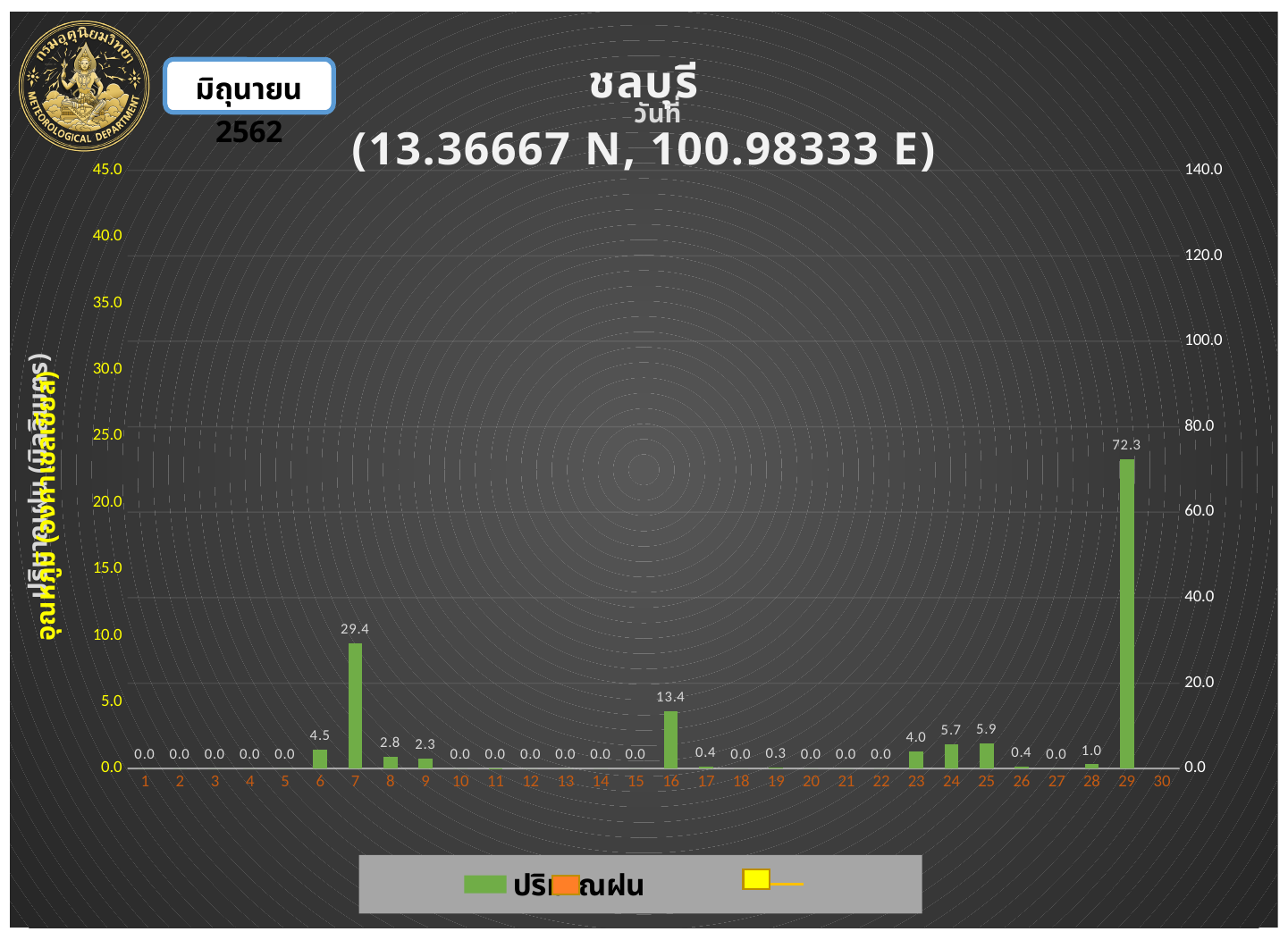
What is the rainfall value shown for day 29? 72.3 Is the value for day 29 greater or less than 60.0 on the right-hand axis? greater What is the rainfall value shown for day 24? 5.7 Which has a larger rainfall value, day 7 or day 16? day 7 What is the rainfall value shown for day 16? 13.4 What coordinates are given in the chart title? 13.36667 N, 100.98333 E Which day has the highest rainfall value? 29 What is the difference between the rainfall values for day 25 and day 24? 0.2 How many days are shown along the x axis? 30 What is the difference between the rainfall values for day 7 and day 16? 16.0 What is the rainfall value shown for day 7? 29.4 What kind of chart is shown on the slide? bar chart